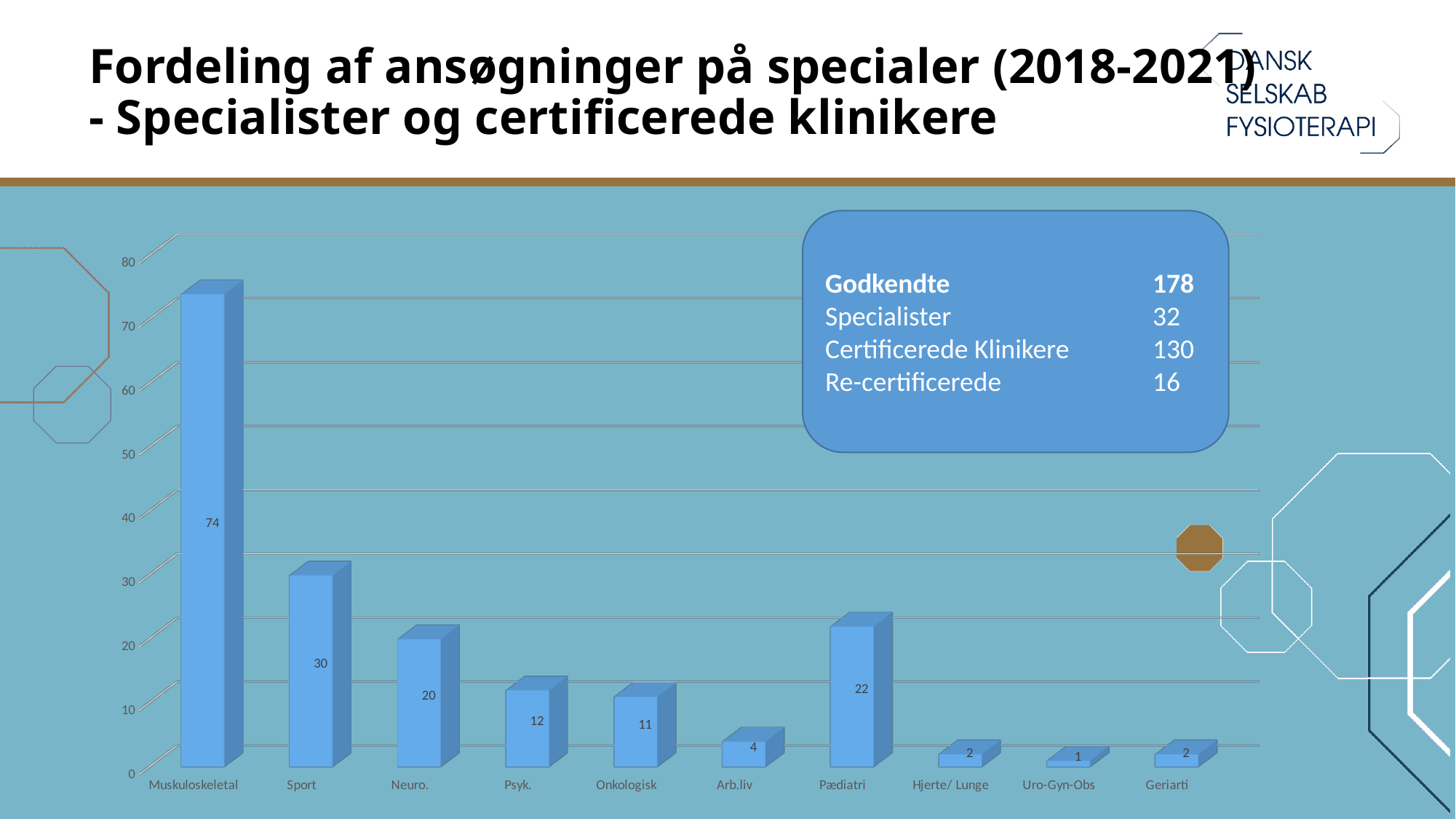
What is the value for Muskuloskeletal? 74 What is the value for Pædiatri? 22 Which category has the highest value? Muskuloskeletal Which category has the lowest value? Uro-Gyn-Obs What is the value for Onkologisk? 11 How many categories are shown on the x axis? 10 What is the difference between the values for Muskuloskeletal and Sport? 44 Which is larger, the value for Psyk. or the value for Pædiatri? Pædiatri What is the difference between the values for Sport and Neuro.? 10 What is the value for Arb.liv? 4 What kind of chart is shown on the slide? bar chart Is the value for Sport greater or less than 20? greater